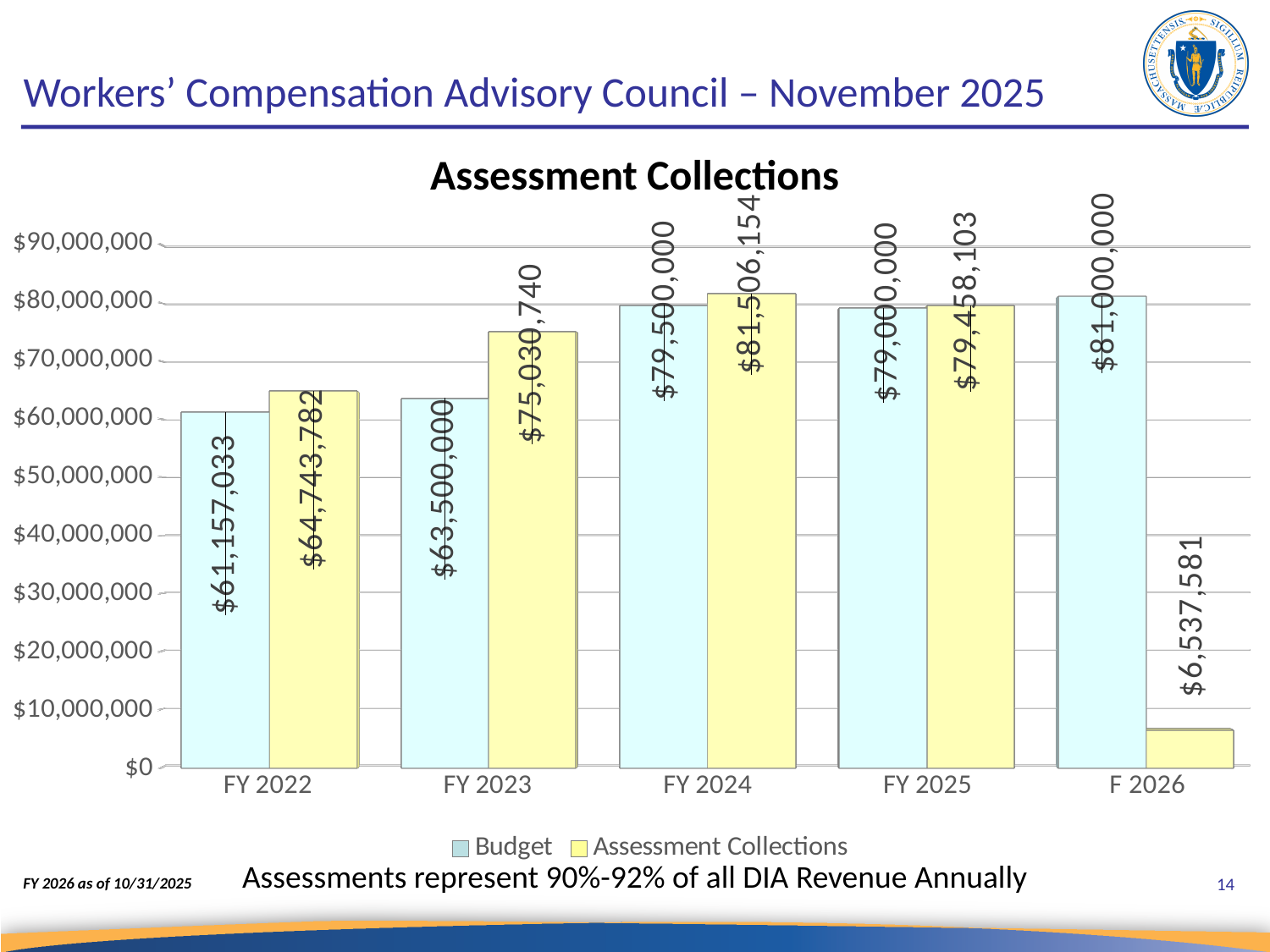
How many fiscal years are shown on the x axis? 5 Which fiscal year has the lowest Assessment Collections value? F 2026 What is the Budget value for FY 2022? $61,157,033 Which fiscal year has the highest Assessment Collections value? FY 2024 What is the difference between Assessment Collections and Budget for FY 2023? $11,530,740 For FY 2023, which is larger: Budget or Assessment Collections? Assessment Collections What type of chart is shown on the slide? Bar chart What is the Assessment Collections value for FY 2024? $81,506,154 Which fiscal year has the highest Budget value? F 2026 What is the Budget value for FY 2023? $63,500,000 What is the Assessment Collections value for F 2026? $6,537,581 How many series does the legend list? 2